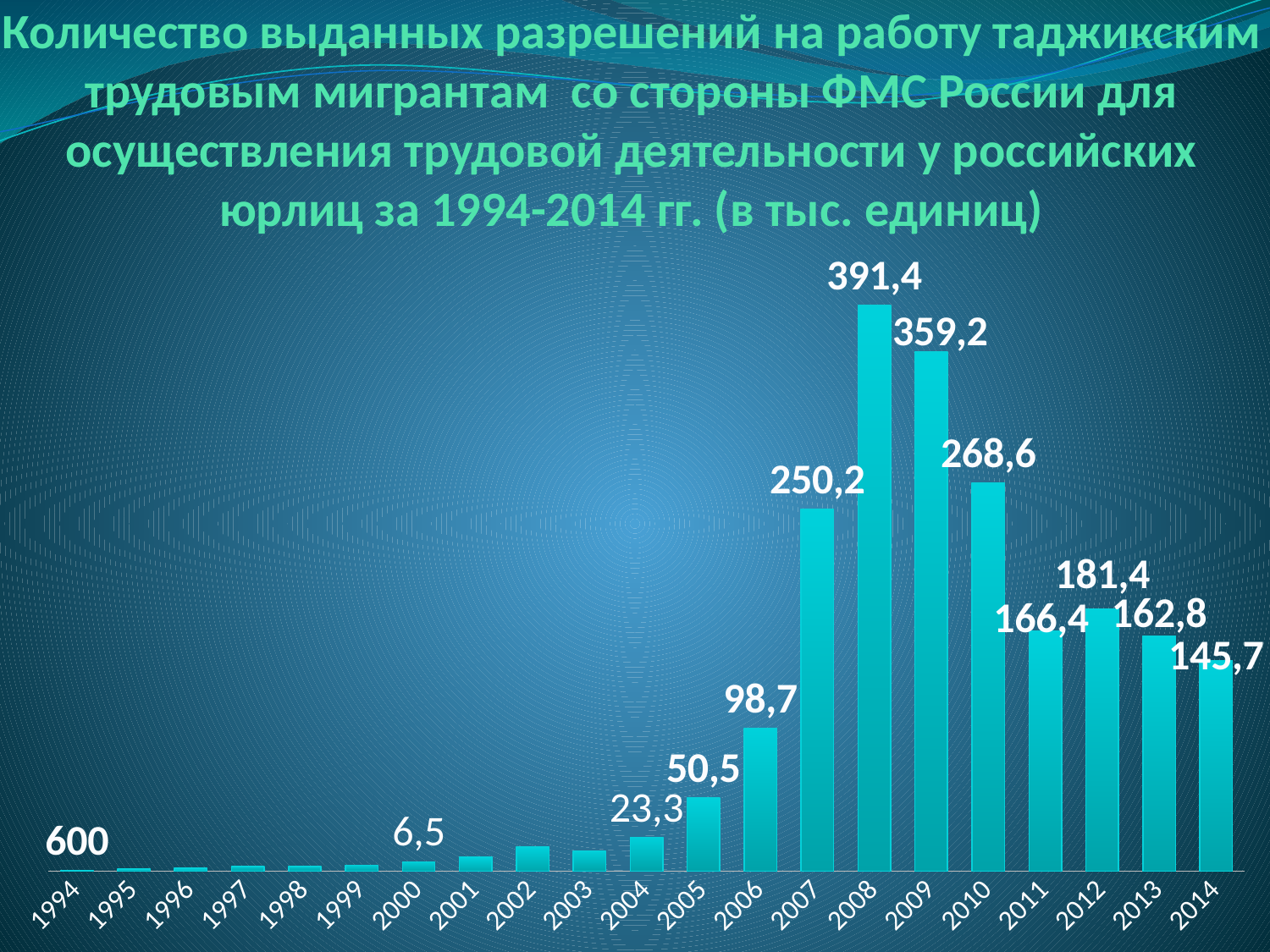
Which year has the highest value? 2008 What is the difference between the values for 2012 and 2011? 15 What value is shown for 2014? 145,7 What is the difference between the values for 2008 and 2009? 32,2 What kind of chart is this? bar chart What value is shown for 2000? 6,5 What value is shown for 2008? 391,4 Do the values rise or fall from 2004 to 2008? rise How many years are shown on the x axis? 21 What value is shown for 2005? 50,5 Which is larger, the value for 2013 or the value for 2012? 2012 Which is larger, the value for 2007 or the value for 2010? 2010